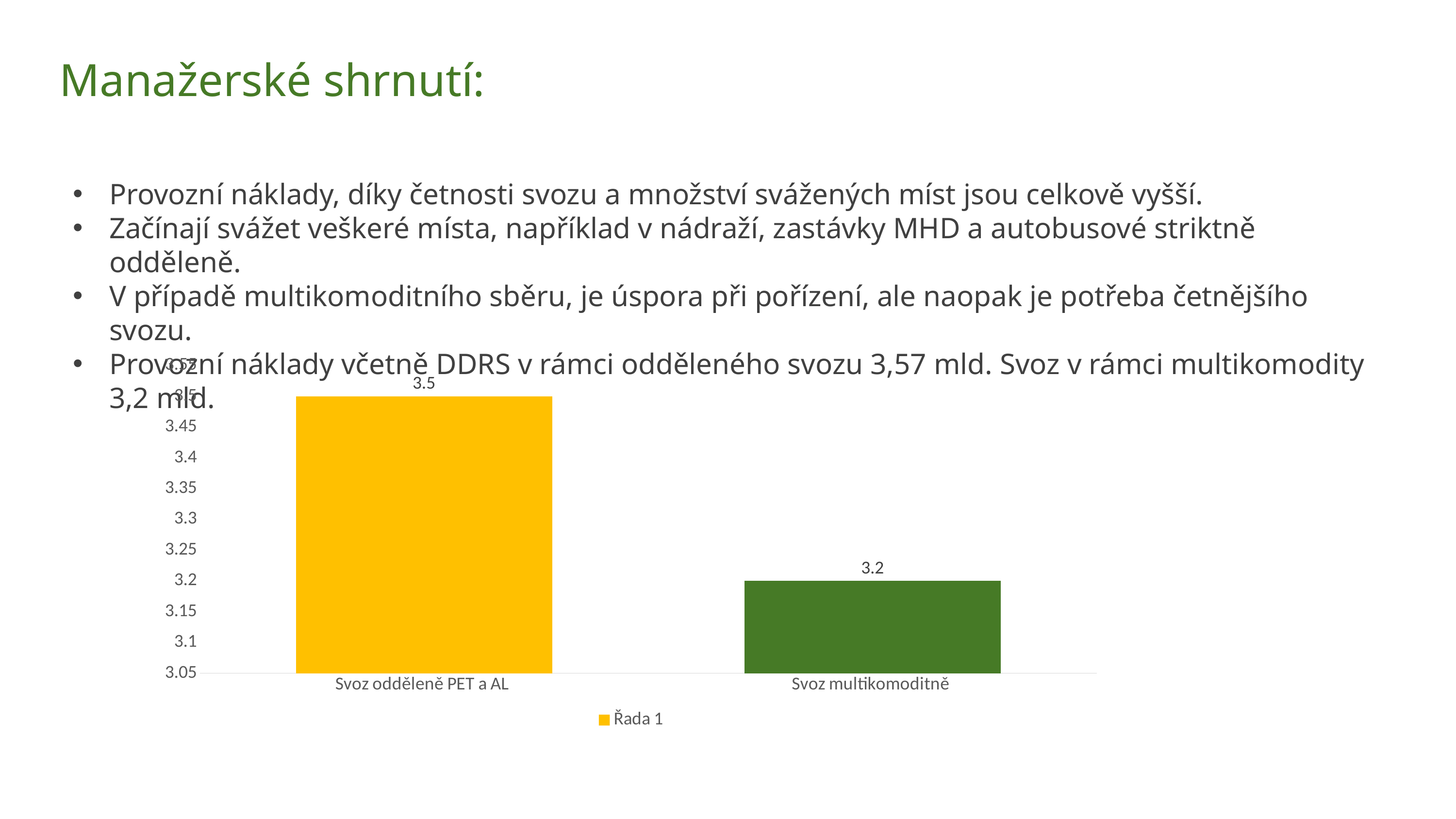
What kind of chart is shown on the slide? bar chart What is the name of the series listed in the legend? Řada 1 How many categories are shown in the chart? 2 What is the value for Svoz odděleně PET a AL? 3.5 What is the value for Svoz multikomoditně? 3.2 Is the value for Svoz odděleně PET a AL greater or less than 3.4? greater Which is larger, the value for Svoz odděleně PET a AL or the value for Svoz multikomoditně? Svoz odděleně PET a AL Which category has the lowest value? Svoz multikomoditně Is the value for Svoz multikomoditně greater or less than 3.3? less How many series does the legend list? 1 What is the difference between the values for Svoz odděleně PET a AL and Svoz multikomoditně? 0.3 Which category has the highest value? Svoz odděleně PET a AL